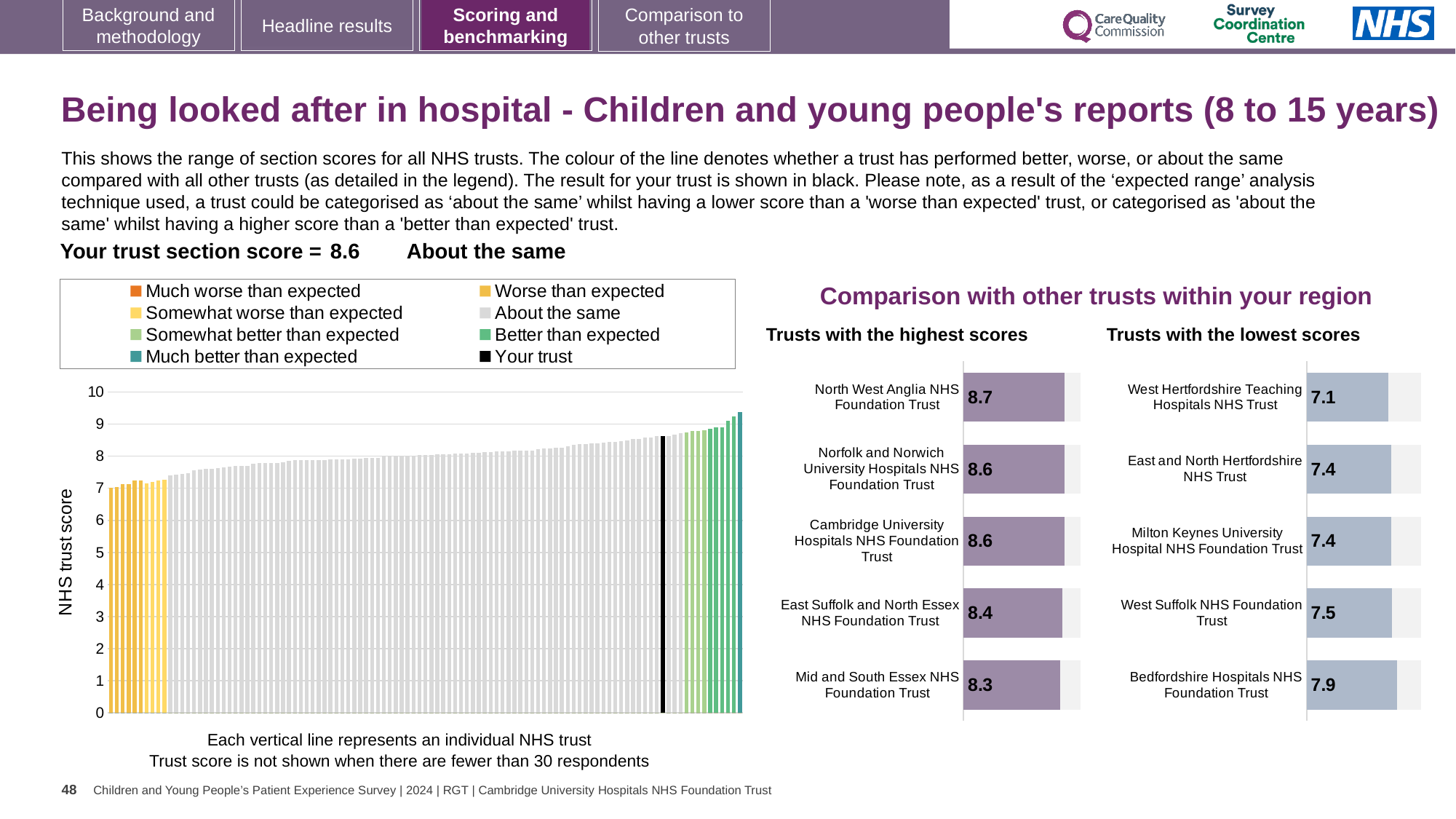
In the 'Trusts with the highest scores' chart, which trust has the lowest score shown? Mid and South Essex NHS Foundation Trust In the 'Trusts with the highest scores' chart, what is the score for North West Anglia NHS Foundation Trust? 8.7 In the main chart showing the range of section scores for all NHS trusts, what kind of chart is it? Bar chart In the 'Trusts with the lowest scores' chart, what is the difference between the scores of Bedfordshire Hospitals NHS Foundation Trust and West Hertfordshire Teaching Hospitals NHS Trust? 0.8 In the 'Trusts with the highest scores' chart, how many trusts are listed? 5 In the 'Trusts with the highest scores' chart, what is the difference between the scores of North West Anglia NHS Foundation Trust and Mid and South Essex NHS Foundation Trust? 0.4 In the 'Trusts with the lowest scores' chart, what is the score for West Hertfordshire Teaching Hospitals NHS Trust? 7.1 How many entries does the legend of the main chart showing the range of section scores list? 8 In the 'Trusts with the lowest scores' chart, which has the larger score: West Suffolk NHS Foundation Trust or Milton Keynes University Hospital NHS Foundation Trust? West Suffolk NHS Foundation Trust In the main chart showing the range of section scores for all NHS trusts, is the value for the black 'Your trust' bar greater or less than 8? greater In the 'Trusts with the lowest scores' chart, which trust has the highest score shown? Bedfordshire Hospitals NHS Foundation Trust In the main chart showing the range of section scores for all NHS trusts, do the values rise or fall from left to right? Rise